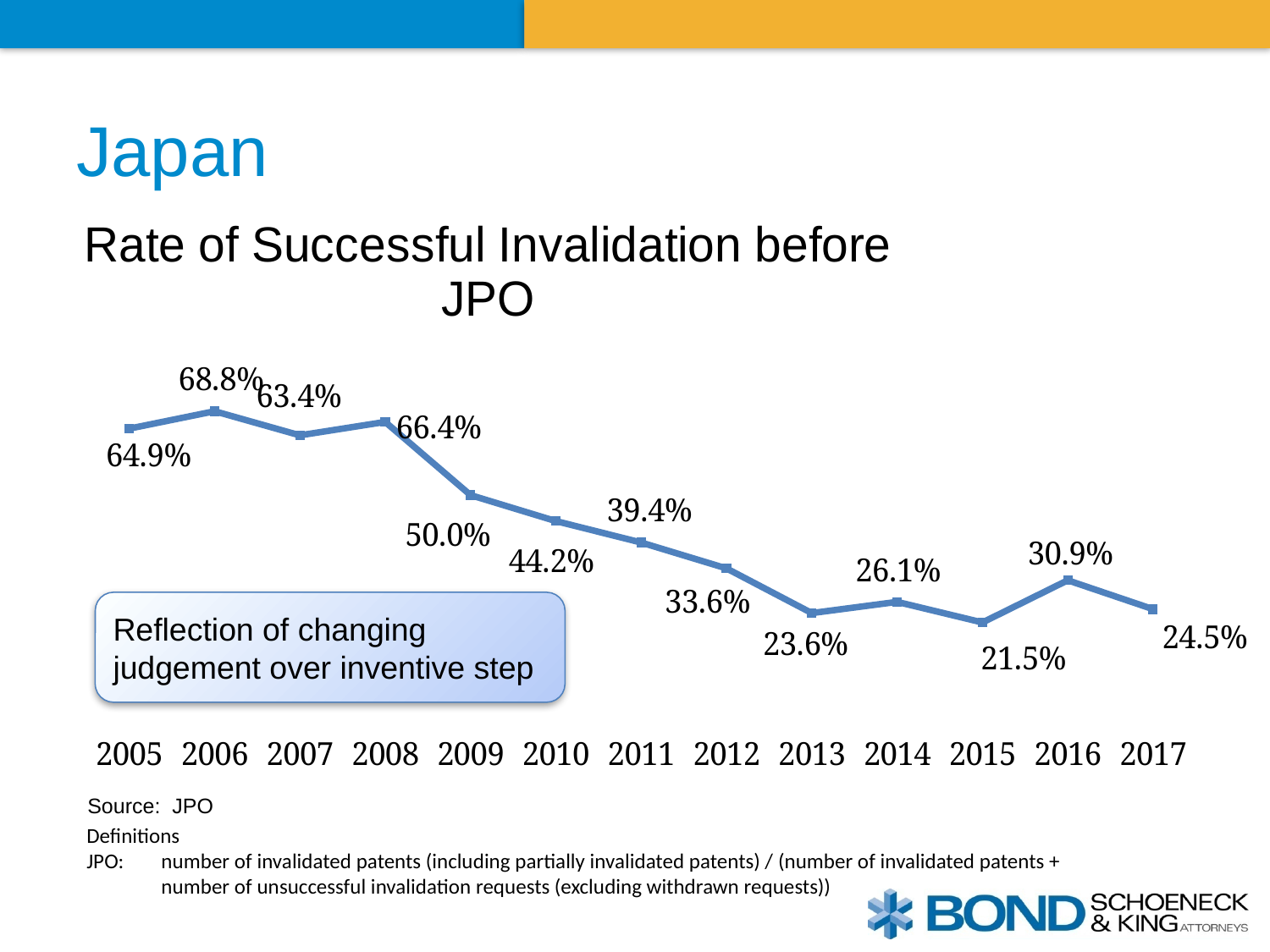
What value is shown for 2009? 50.0% How many years are plotted on the chart? 13 Which year has the highest rate of successful invalidation? 2006 What is the difference between the 2005 value and the 2017 value? 40.4 percentage points By how many percentage points did the rate fall from 2008 to 2009? 16.4 percentage points What value is plotted for 2013? 23.6% What kind of chart is shown on the slide? Line chart What is the rate shown for 2017? 24.5% What is the rate of successful invalidation before the JPO in 2005? 64.9% Which year has the higher rate, 2014 or 2016? 2016 Which year has the lowest rate of successful invalidation? 2015 Does the rate of successful invalidation generally rise or fall from 2005 to 2017? Fall